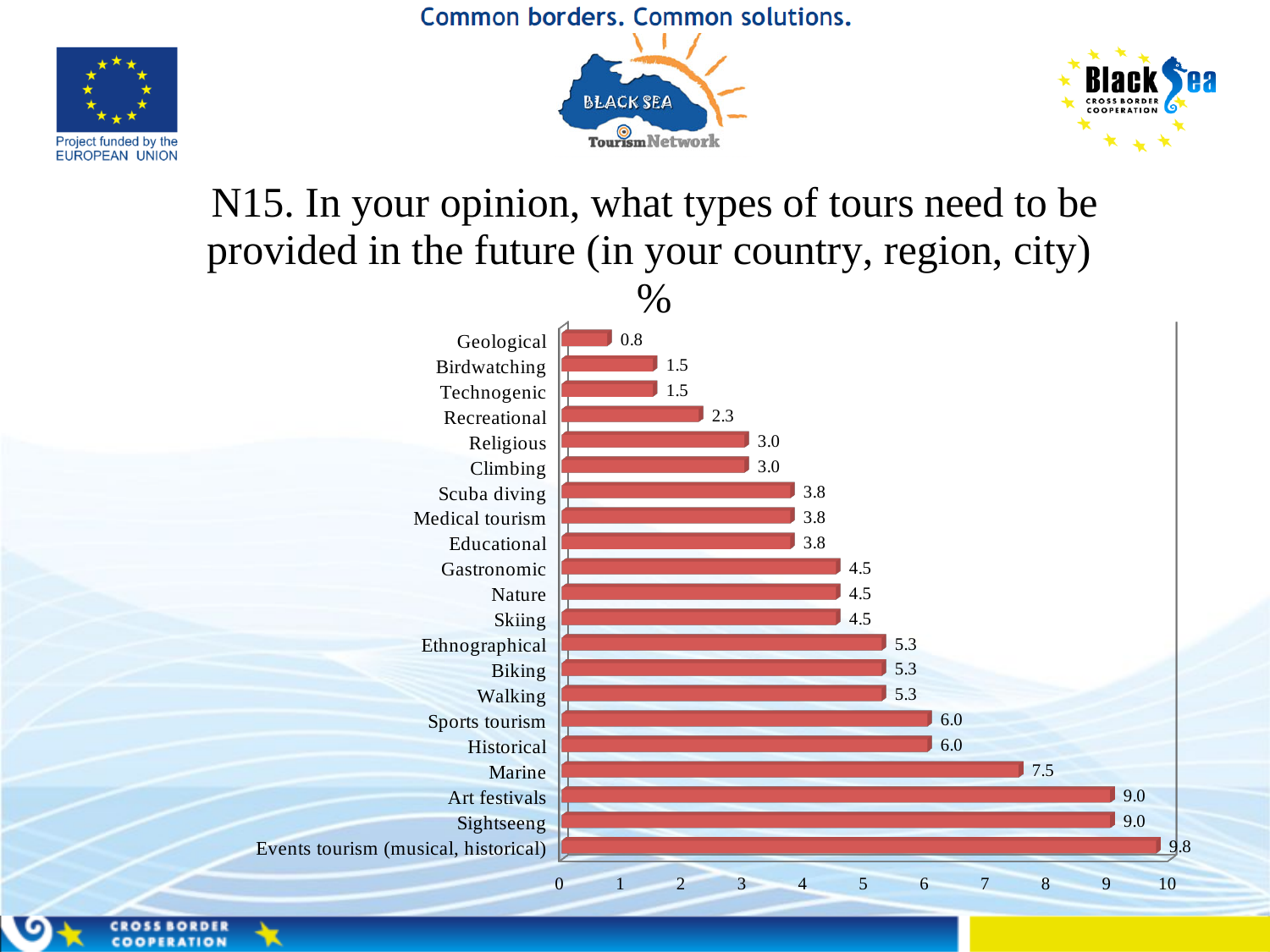
Is the value for Art festivals greater or less than 8? greater What is the difference between the values for Historical and Scuba diving? 2.2 How many categories are shown in the chart? 21 Which category has the lowest value? Geological What is the maximum value shown on the horizontal axis? 10 What is the value for Recreational? 2.3 What kind of chart is shown on the slide? Bar chart Which is larger, the value for Gastronomic or the value for Climbing? Gastronomic What is the value for Ethnographical? 5.3 What is the difference between the values for Events tourism (musical, historical) and Marine? 2.3 Which category has the highest value? Events tourism (musical, historical) What is the value for Marine? 7.5